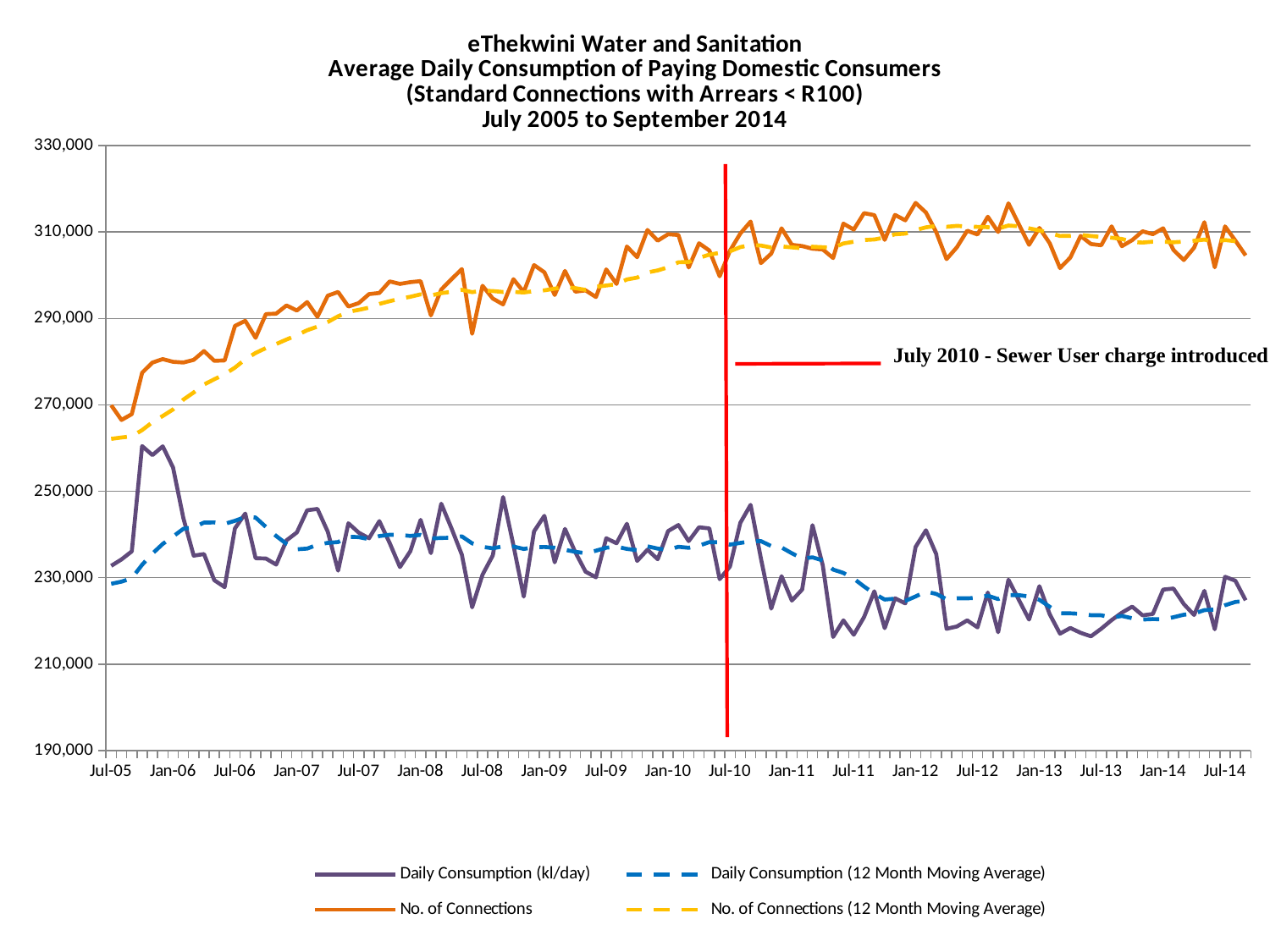
Does the No. of Connections series generally rise or fall from Jul-05 to Jul-14? rise Is the No. of Connections value at Jul-14 greater or less than 290,000? greater What period does the chart title say the data covers? July 2005 to September 2014 What event does the red vertical line on the chart mark? July 2010 - Sewer User charge introduced What kind of chart is shown on the slide? line chart At Jan-12, which is larger: No. of Connections or Daily Consumption (kl/day)? No. of Connections Does the Daily Consumption (kl/day) series generally rise or fall between Jul-10 and Jul-13? fall Is the No. of Connections value at Jan-06 greater or less than 270,000? greater Is the Daily Consumption (kl/day) value at Jul-13 greater or less than 230,000? less Is Daily Consumption (kl/day) higher at Jan-06 or at Jul-13? Jan-06 How many series does the legend list? 4